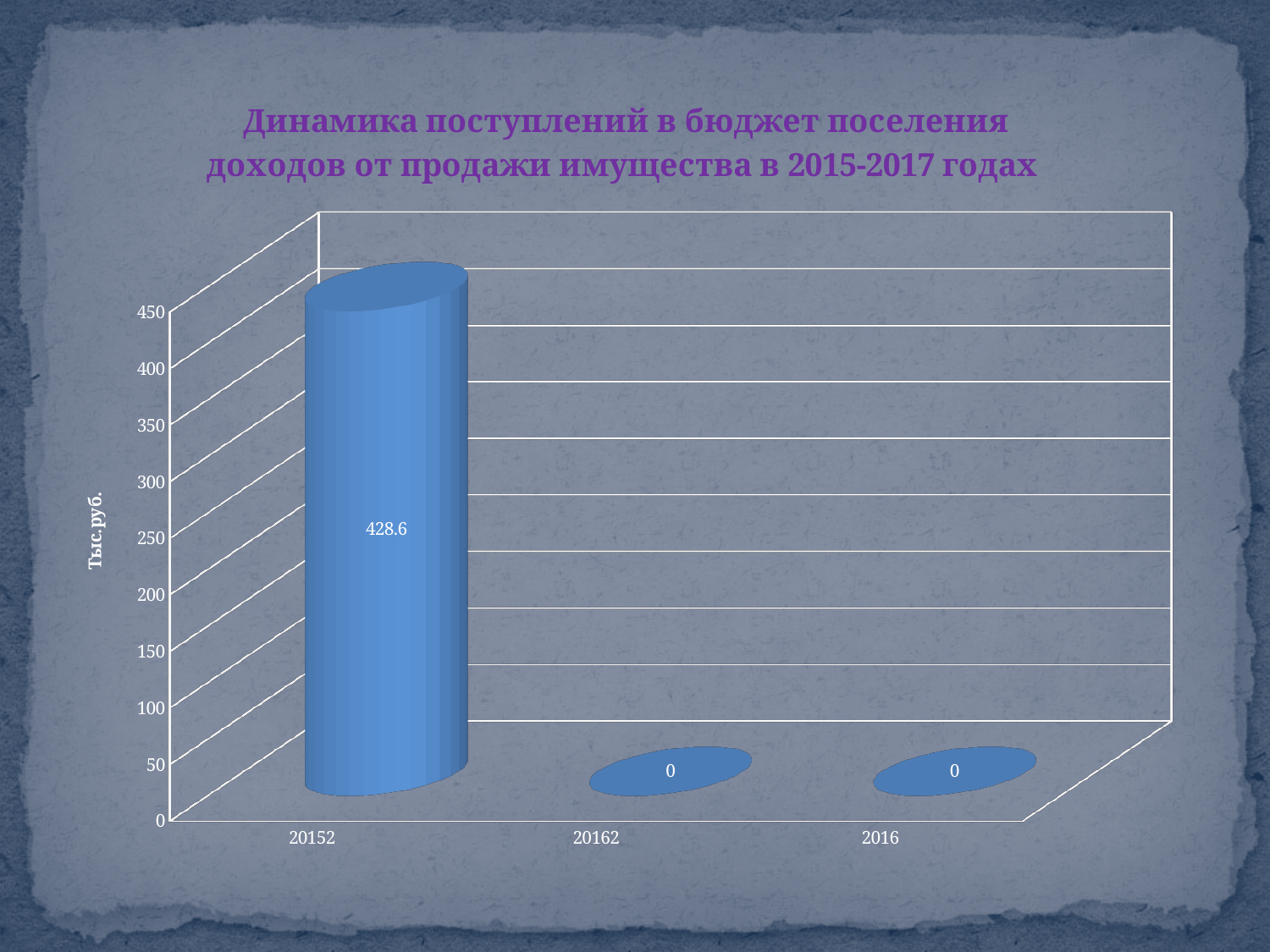
What is the title of the vertical axis? Тыс.руб. How many categories are shown on the x axis? 3 What is the value for the category labelled 20152? 428.6 Do the values rise or fall from the first category to the last along the x axis? fall What is the title of the chart? Динамика поступлений в бюджет поселения доходов от продажи имущества в 2015-2017 годах Is the value for 20152 greater or less than 400? greater What is the value for the category labelled 20162? 0 What kind of chart is shown on the slide? bar chart What is the value for the category labelled 2016? 0 Which category has the highest value? 20152 Which is larger, the value for 20152 or the value for 2016? 20152 What is the difference between the value for 20152 and the value for 20162? 428.6